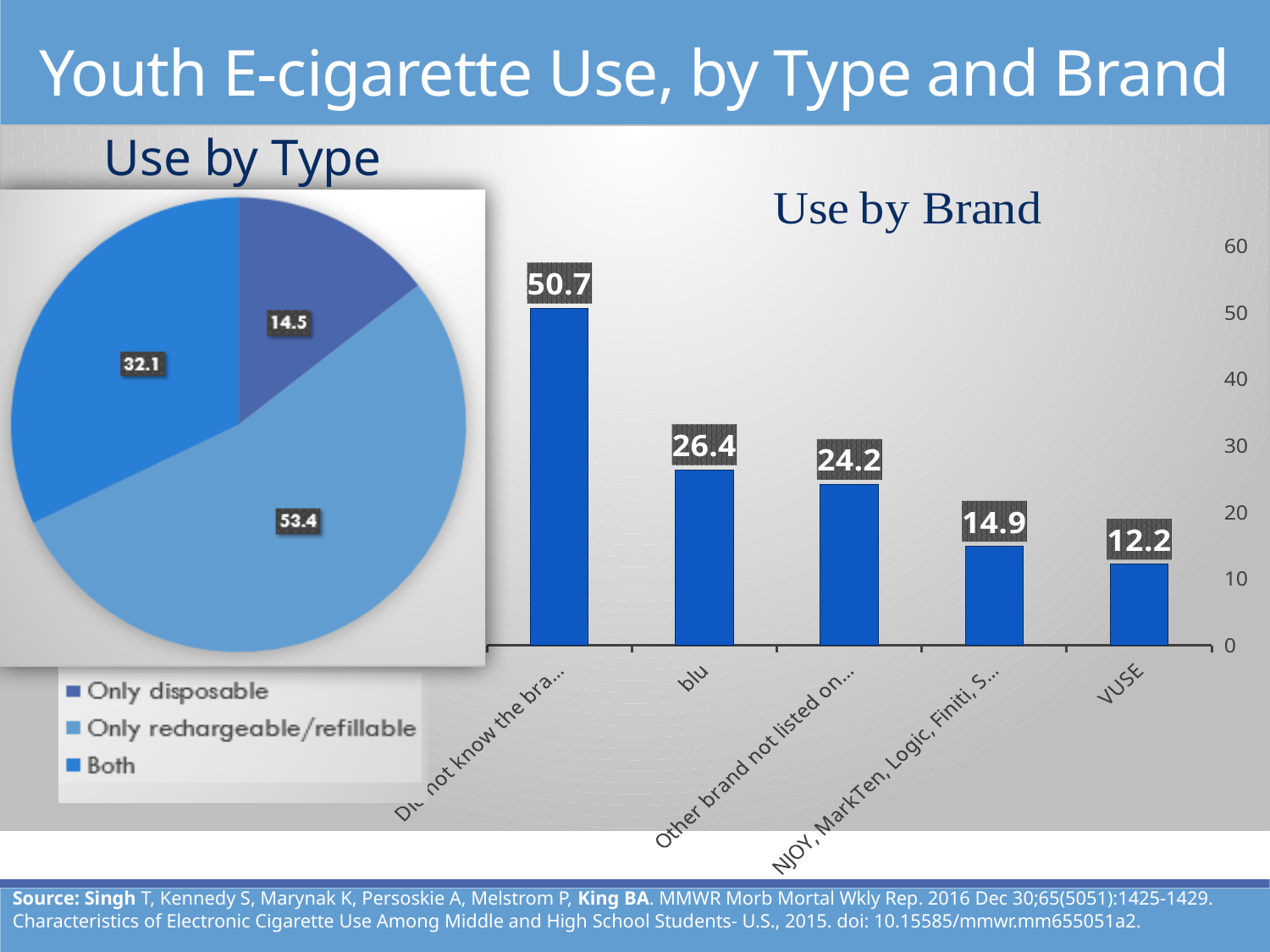
In the Use by Brand chart, which is larger, the value for blu or the value for VUSE? blu In the Use by Brand chart, what is the difference between the values for blu and VUSE? 14.2 In the Use by Type pie chart, what is the value for Only rechargeable/refillable? 53.4 In the Use by Type pie chart, what is the value for Only disposable? 14.5 In the Use by Brand chart, what is the value for blu? 26.4 What kind of chart is the Use by Brand chart? Bar chart In the Use by Brand chart, what is the value for VUSE? 12.2 In the Use by Brand chart, which brand category has the lowest value? VUSE How many categories does the legend of the Use by Type pie chart list? 3 In the Use by Type pie chart, which category has the largest slice? Only rechargeable/refillable In the Use by Brand chart, how many bars are plotted? 5 In the Use by Brand chart, what is the value of the first (leftmost) bar? 50.7